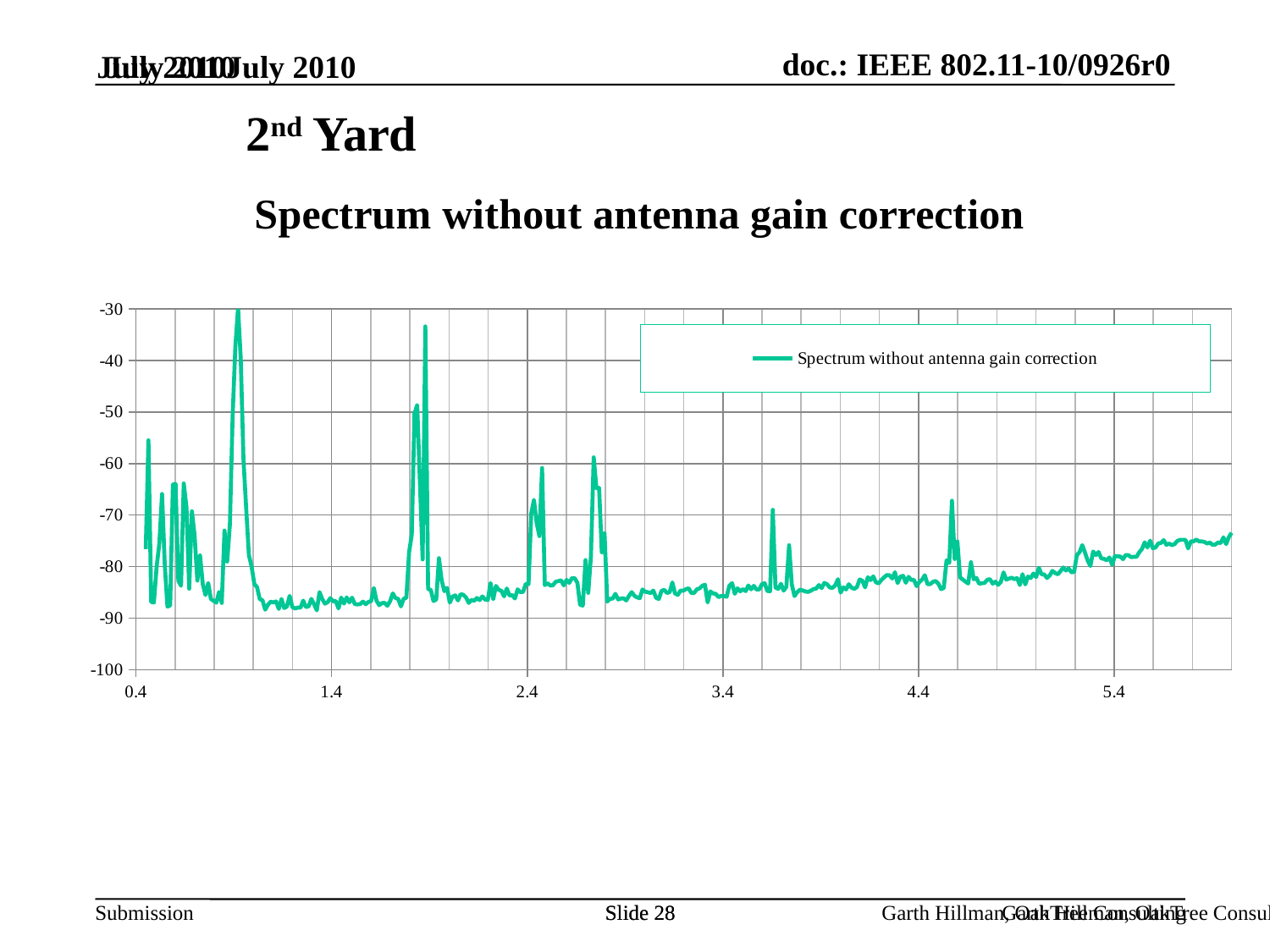
Is the value of the line at x = 1.4 greater or less than -80? less What is the name of the series shown in the legend? Spectrum without antenna gain correction What kind of chart is shown on the slide? line chart Is the highest peak of the line greater or less than -40? greater Between x = 4.4 and the right end of the axis, does the line generally rise or fall? rise How many series does the legend list? 1 Is the line's value at x = 5.8 larger or smaller than its value at x = 1.4? larger Is the value of the line at x = 5.8 greater or less than -80? greater What is the lowest value shown on the y axis? -100 What is the title of the chart? Spectrum without antenna gain correction